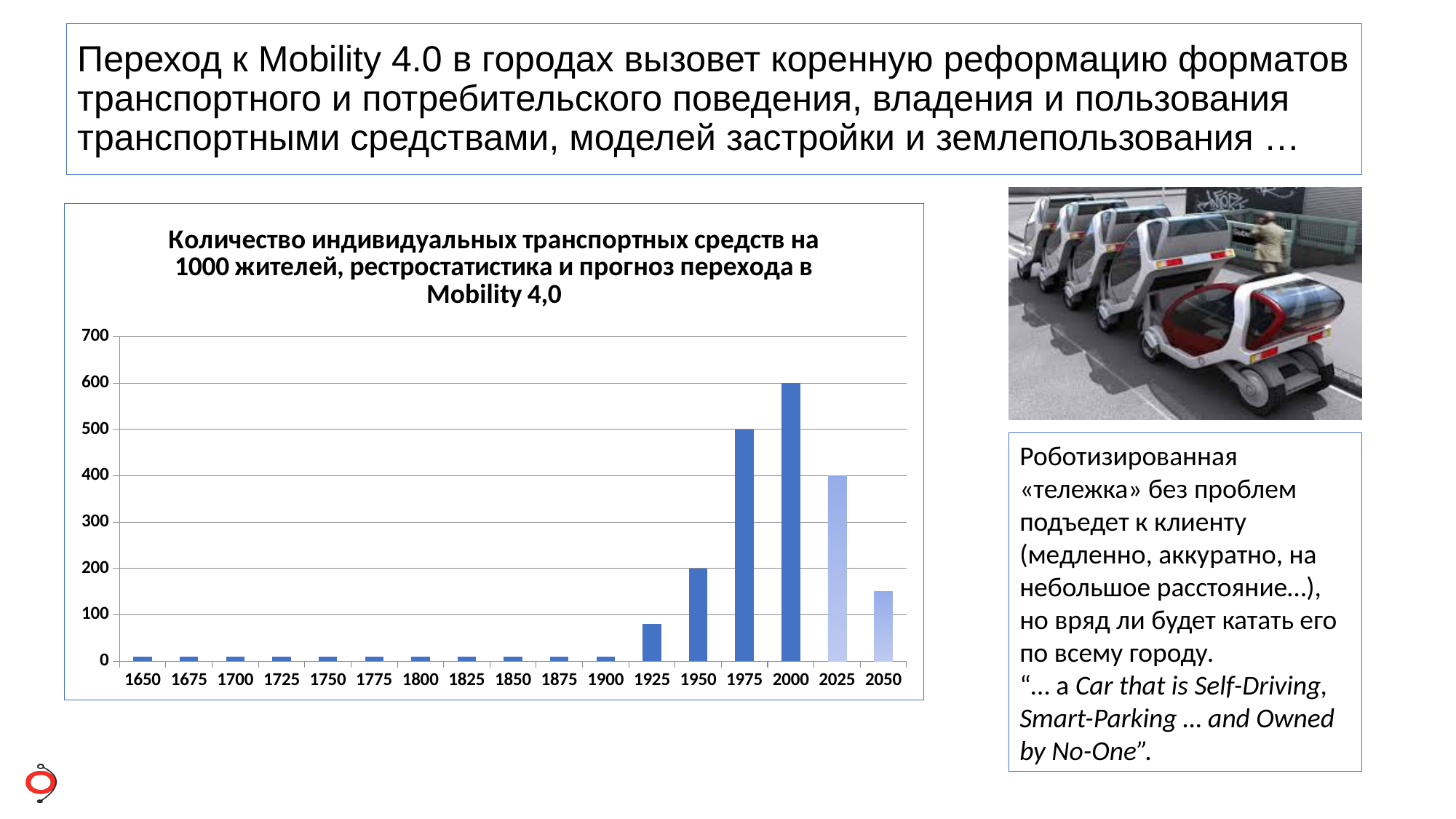
What is the value for 1950 in the chart? 200 What is the value for 2025 in the chart? 400 Which is larger, the value for 2025 or the value for 2050? 2025 What kind of chart is shown on the slide? bar chart Is the value for 1925 greater or less than 100? less Do the values rise or fall from 1900 to 2000? rise What is the title of the chart? Количество индивидуальных транспортных средств на 1000 жителей, рестростатистика и прогноз перехода в Mobility 4,0 Which year has the highest bar in the chart? 2000 How many years (categories) are shown on the x axis of the chart? 17 What is the value for 2000 in the chart? 600 What is the difference between the values for 2000 and 1975? 100 What is the value for 1975 in the chart? 500